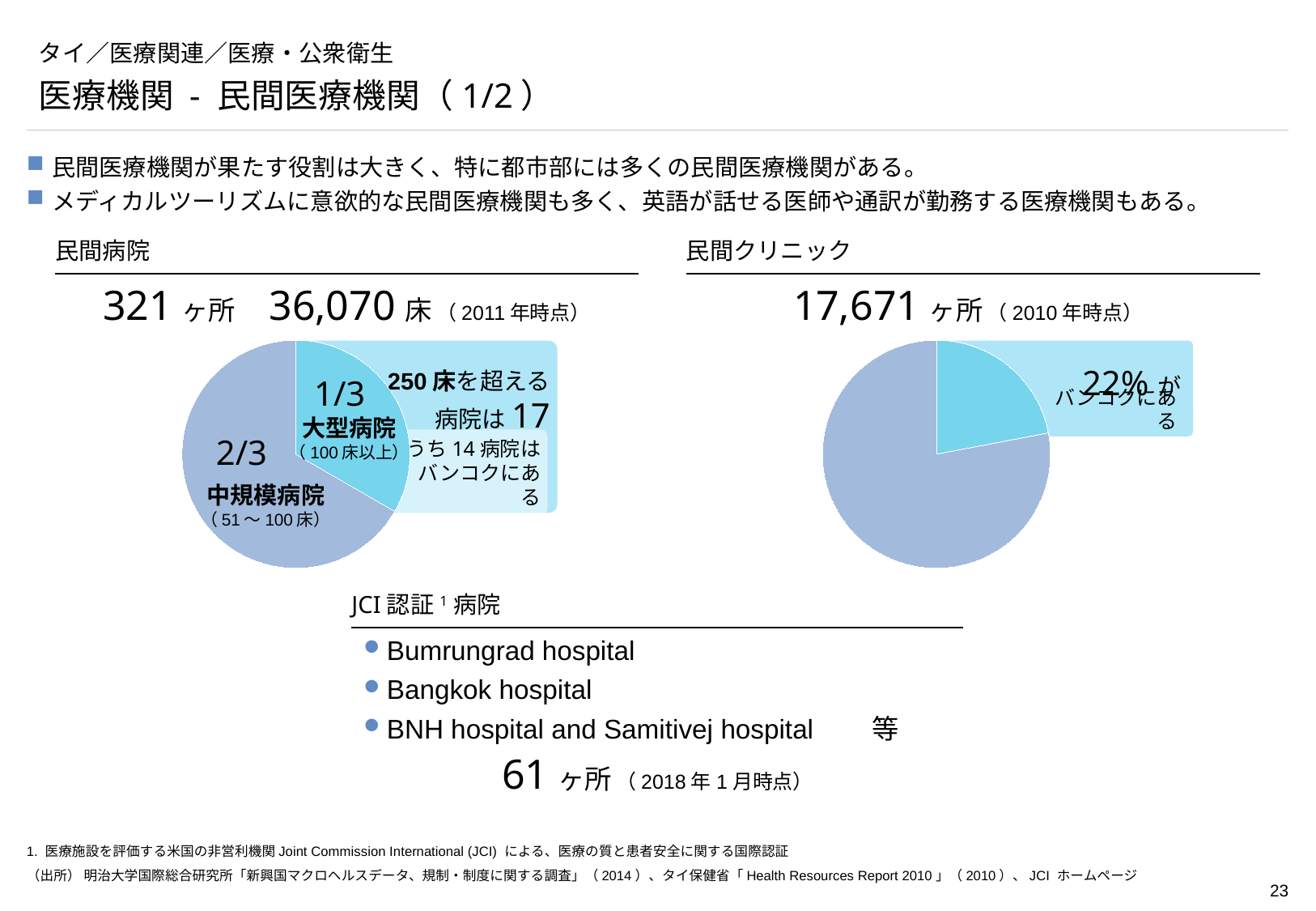
In the 民間病院 pie chart, which slice is larger: 大型病院 or 中規模病院? 中規模病院 How many slices does the 民間クリニック pie chart have? 2 In the 民間病院 pie chart, which category has the smallest share? 大型病院 In the 民間病院 pie chart, which category has the largest share? 中規模病院 What kind of chart is used under the 民間クリニック heading? pie chart In the 民間病院 pie chart, what bed-size range is given for 中規模病院? 51〜100床 What kind of chart is used under the 民間病院 heading? pie chart In the 民間病院 pie chart, what share of private hospitals are 中規模病院 (51〜100床)? 2/3 How many slices does the 民間病院 pie chart have? 2 In the 民間クリニック pie chart, what share of private clinics are in Bangkok (バンコクにある)? 22% In the 民間クリニック pie chart, is the Bangkok slice (22%) larger or smaller than the remaining slice? smaller In the 民間病院 pie chart, what share of private hospitals are 大型病院 (100床以上)? 1/3